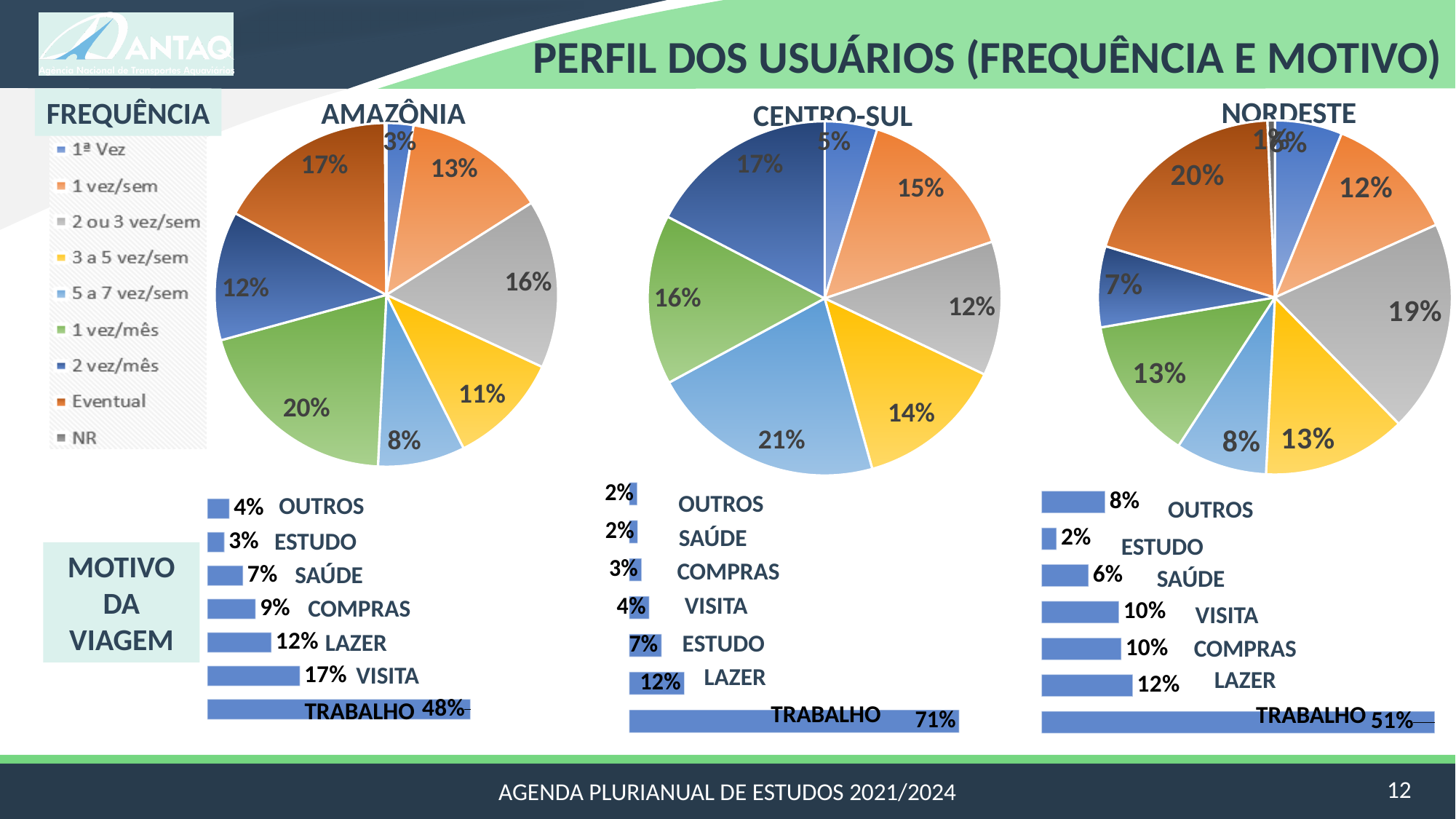
In the Nordeste frequency pie chart, what share of users travel Eventual? 20% In the Centro-Sul frequency pie chart, what share of users travel 5 a 7 vez/sem? 21% In the Centro-Sul motivo da viagem bar chart, what is the difference between TRABALHO and LAZER? 59% In the Amazônia motivo da viagem bar chart, what is the value for TRABALHO? 48% In the Amazônia frequency pie chart, what share of users travel 1 vez/mês? 20% How many categories are shown in the Amazônia motivo da viagem bar chart? 7 What type of chart is used to show the frequency data for each region? Pie chart In the Centro-Sul motivo da viagem bar chart, what is the value for LAZER? 12% In the Centro-Sul frequency pie chart, which category has the largest share? 5 a 7 vez/sem In the Nordeste motivo da viagem bar chart, what is the value for OUTROS? 8% In the Nordeste motivo da viagem bar chart, which is larger, SAÚDE or VISITA? VISITA